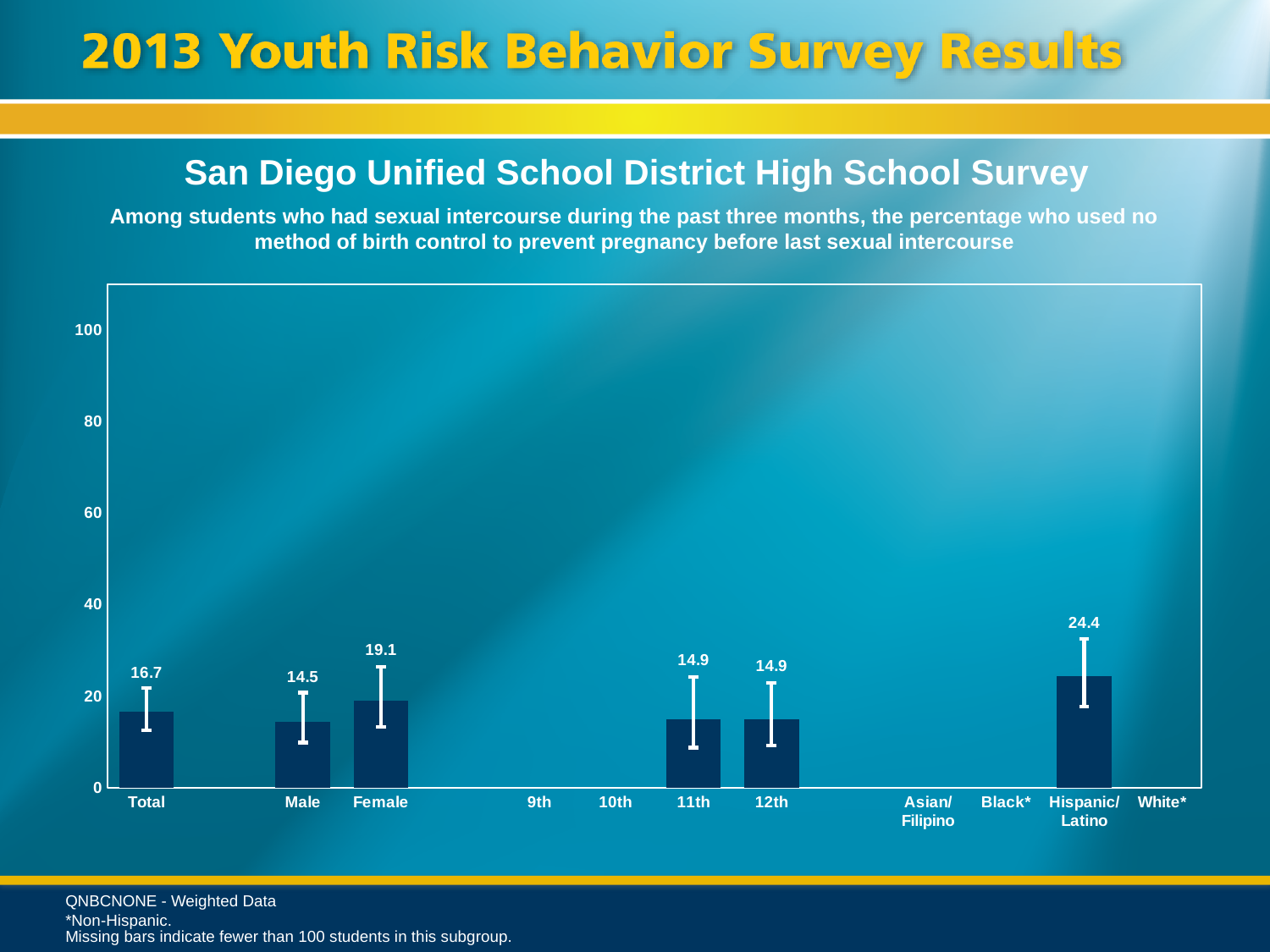
What kind of chart is shown? bar chart Which plotted category has the lowest value? Male What is the value for Total? 16.7 What is the difference between the Hispanic/Latino and Total values? 7.7 What is the value for Female? 19.1 How many bars are plotted on the chart? 6 Which category has the highest value? Hispanic/Latino What is the value for 11th? 14.9 What is the difference between the Female and Male values? 4.6 Which is larger, the value for Female or the value for Male? Female Is the value for Hispanic/Latino greater or less than 20? greater What is the value for Hispanic/Latino? 24.4